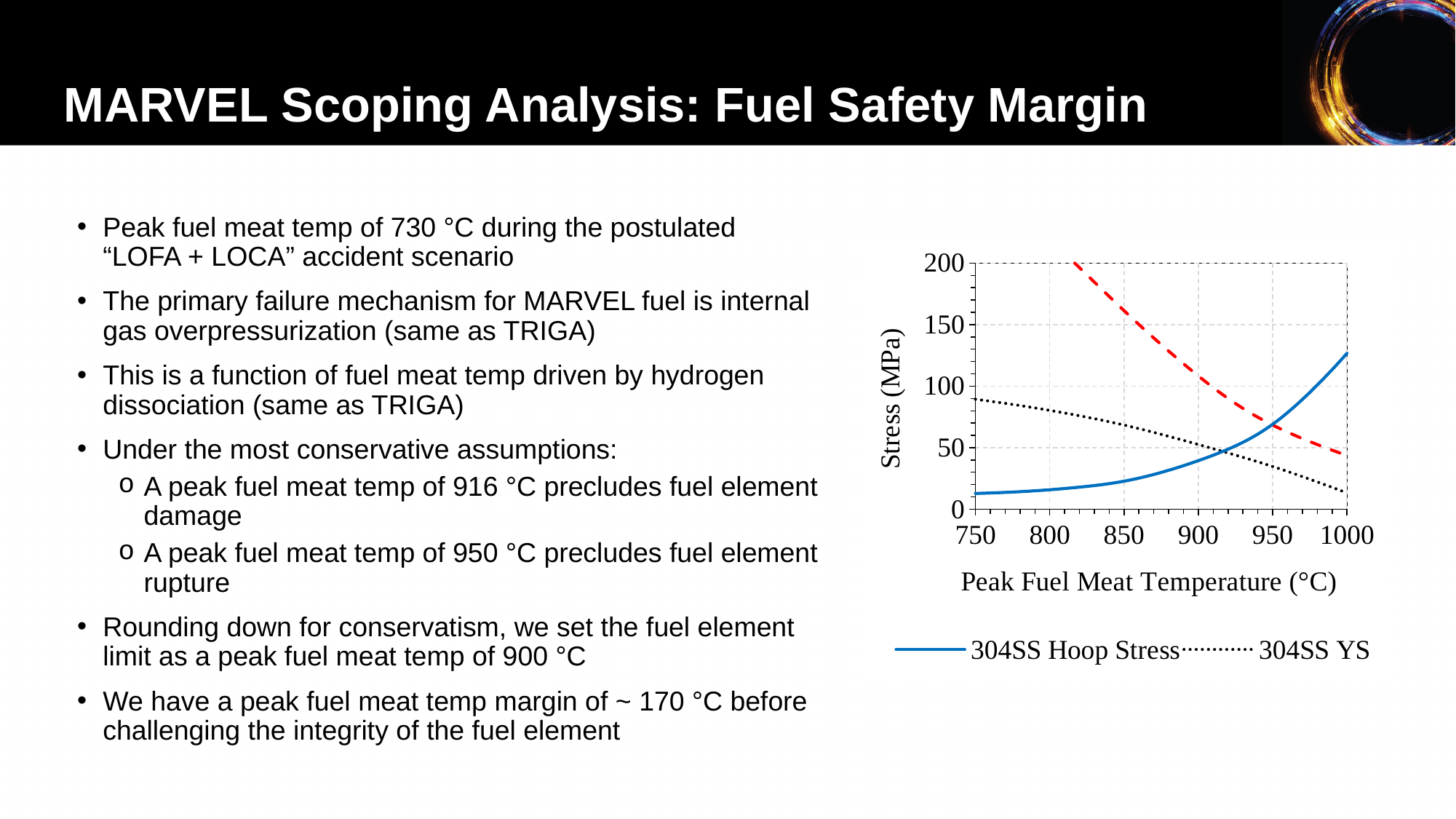
Does the 304SS YS line rise or fall as peak fuel meat temperature increases? fall At 750 °C, which is larger: 304SS Hoop Stress or 304SS YS? 304SS YS Is the 304SS YS value at 750 °C greater or less than 50 MPa? greater Does the 304SS Hoop Stress line rise or fall as peak fuel meat temperature increases? rise What is the label of the y axis of the chart? Stress (MPa) At 1000 °C, which is larger: 304SS Hoop Stress or 304SS YS? 304SS Hoop Stress Is the 304SS Hoop Stress value at 1000 °C greater or less than 100 MPa? greater How many series does the chart legend list? 2 What kind of chart is shown on the slide? line chart Is the 304SS YS value at 1000 °C greater or less than 50 MPa? less What is the label of the x axis of the chart? Peak Fuel Meat Temperature (°C)